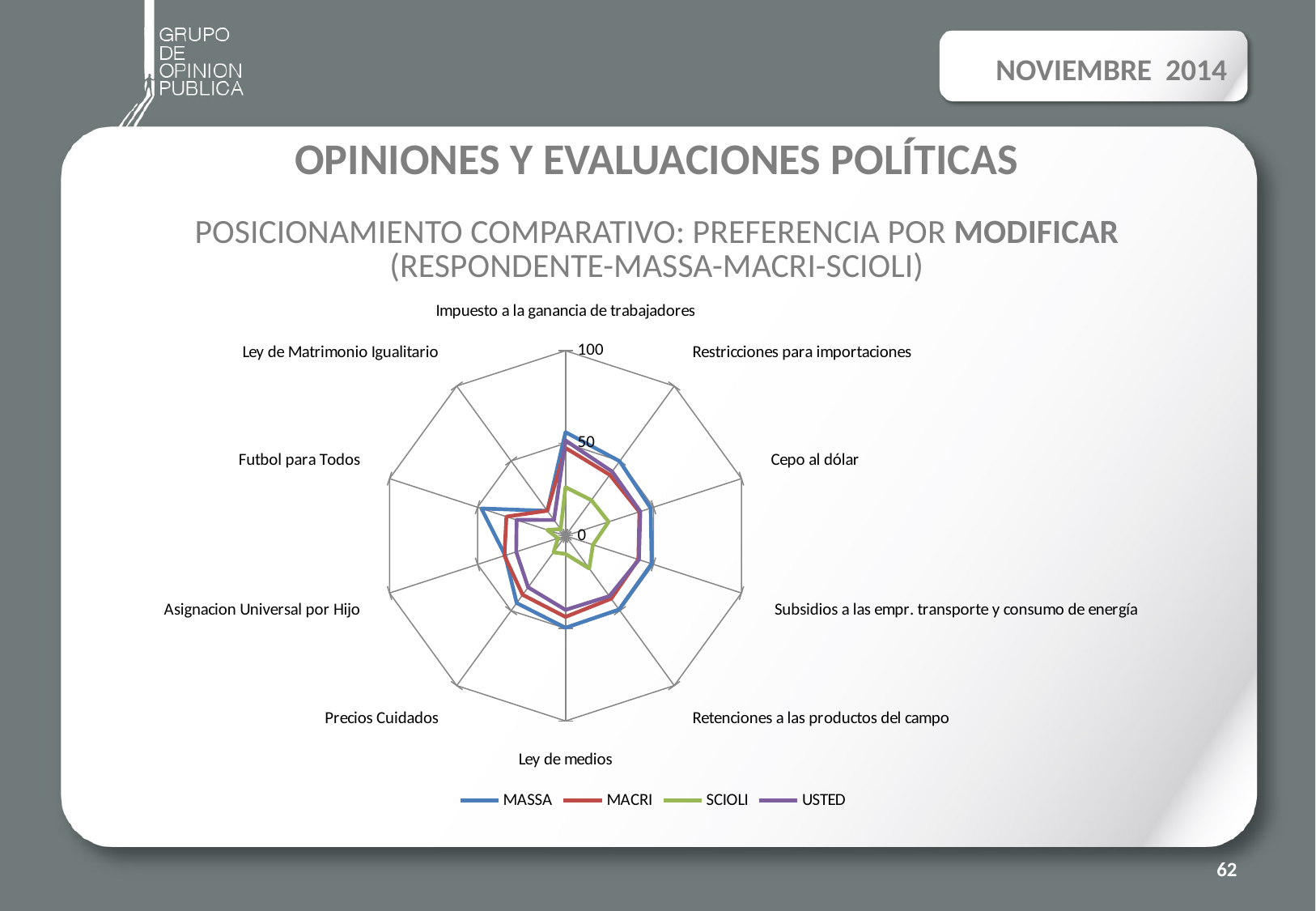
How many categories (policy items) are plotted on the radar chart? 10 For Futbol para Todos, which series has the highest value? MASSA Is the SCIOLI value for Ley de Matrimonio Igualitario greater or less than 50? less For Ley de medios, which is larger: the MASSA value or the SCIOLI value? MASSA How many series does the legend list? 4 What kind of chart is shown on the slide? Radar chart Which colour represents the SCIOLI series? Green Is the SCIOLI value for Impuesto a la ganancia de trabajadores greater or less than 50? less Which series are listed in the legend? MASSA, MACRI, SCIOLI, USTED For Futbol para Todos, which series has the lowest value? SCIOLI Is the SCIOLI value for Cepo al dólar greater or less than 50? less